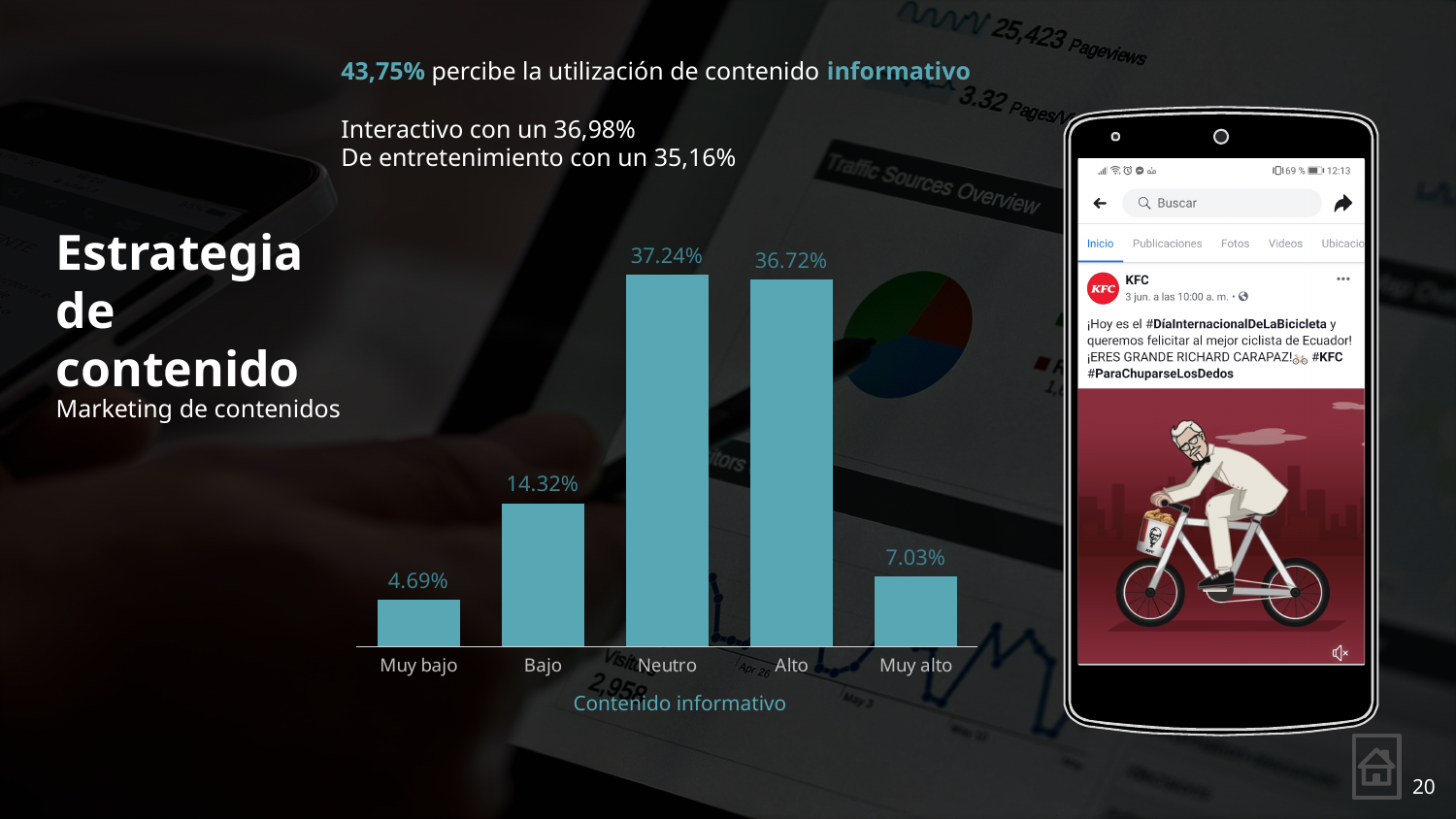
What kind of chart is the Contenido informativo chart? Bar chart What is the label shown below the category axis of the chart? Contenido informativo What is the difference between the values for Neutro and Alto in the Contenido informativo chart? 0.52% What is the value for Bajo in the Contenido informativo chart? 14.32% Which category has the highest value in the Contenido informativo chart? Neutro What is the difference between the values for Bajo and Muy alto in the Contenido informativo chart? 7.29% What is the value for Muy alto in the Contenido informativo chart? 7.03% How many categories are shown in the Contenido informativo chart? 5 Which is larger in the Contenido informativo chart, Bajo or Muy alto? Bajo What is the value for Muy bajo in the Contenido informativo chart? 4.69% Which category has the lowest value in the Contenido informativo chart? Muy bajo What is the value for Neutro in the Contenido informativo chart? 37.24%